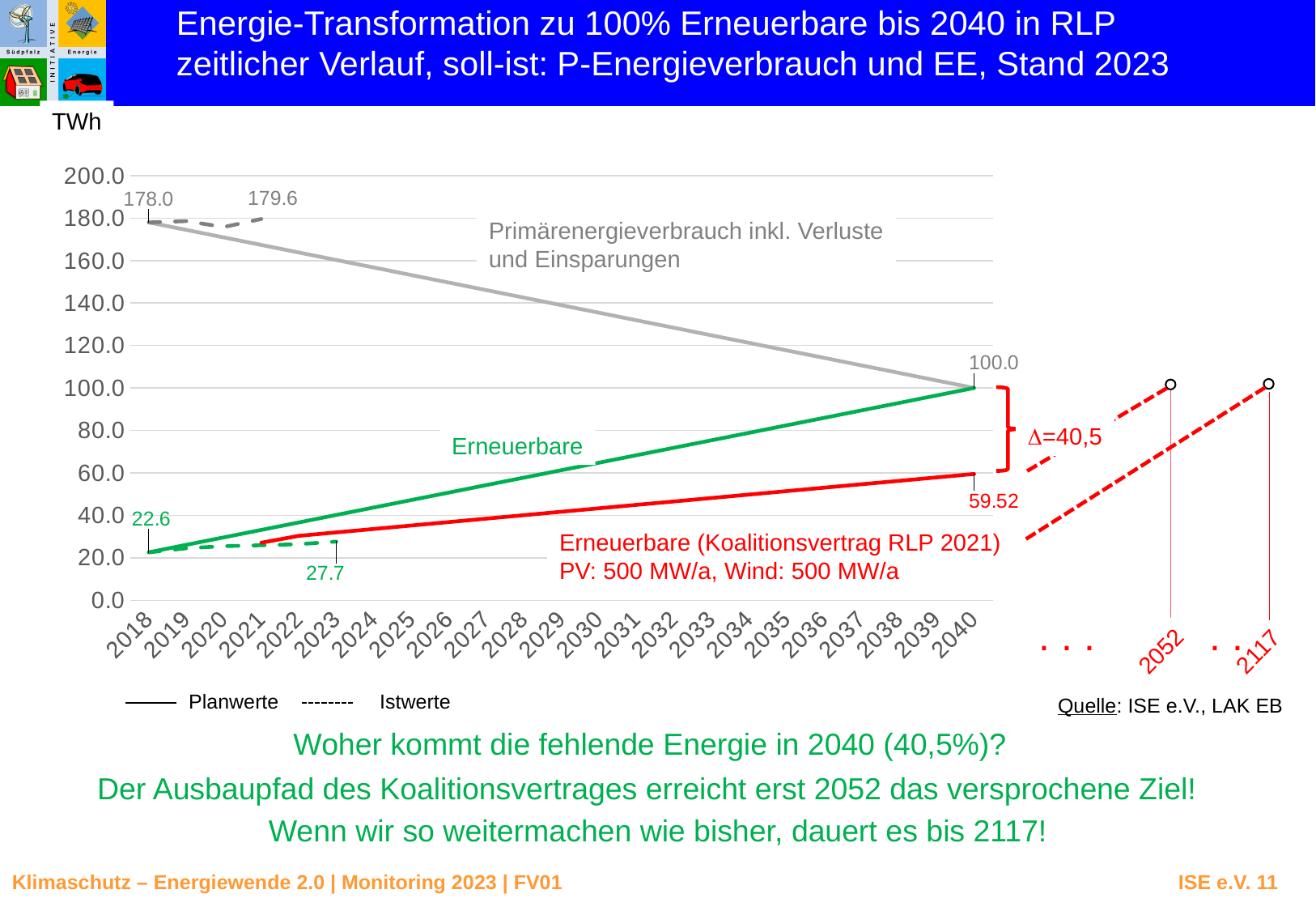
Is the value of Primärenergieverbrauch in 2035 greater or less than 140? less What value do the Primärenergieverbrauch and Erneuerbare lines meet at in 2040? 100.0 Does the Primärenergieverbrauch line rise or fall from 2018 to 2040? fall How many years are shown on the x axis from 2018 to 2040? 23 What is the value of Primärenergieverbrauch in 2018? 178.0 What is the difference between Primärenergieverbrauch and Erneuerbare in 2018? 155.4 What two line styles does the legend list? Planwerte and Istwerte Which is larger in 2018, Primärenergieverbrauch or Erneuerbare? Primärenergieverbrauch What is the value of Erneuerbare in 2018? 22.6 What value does the Erneuerbare (Koalitionsvertrag RLP 2021) line reach in 2040? 59.52 What is the Istwert for Erneuerbare in 2023? 27.7 What kind of chart is shown on the slide? line chart